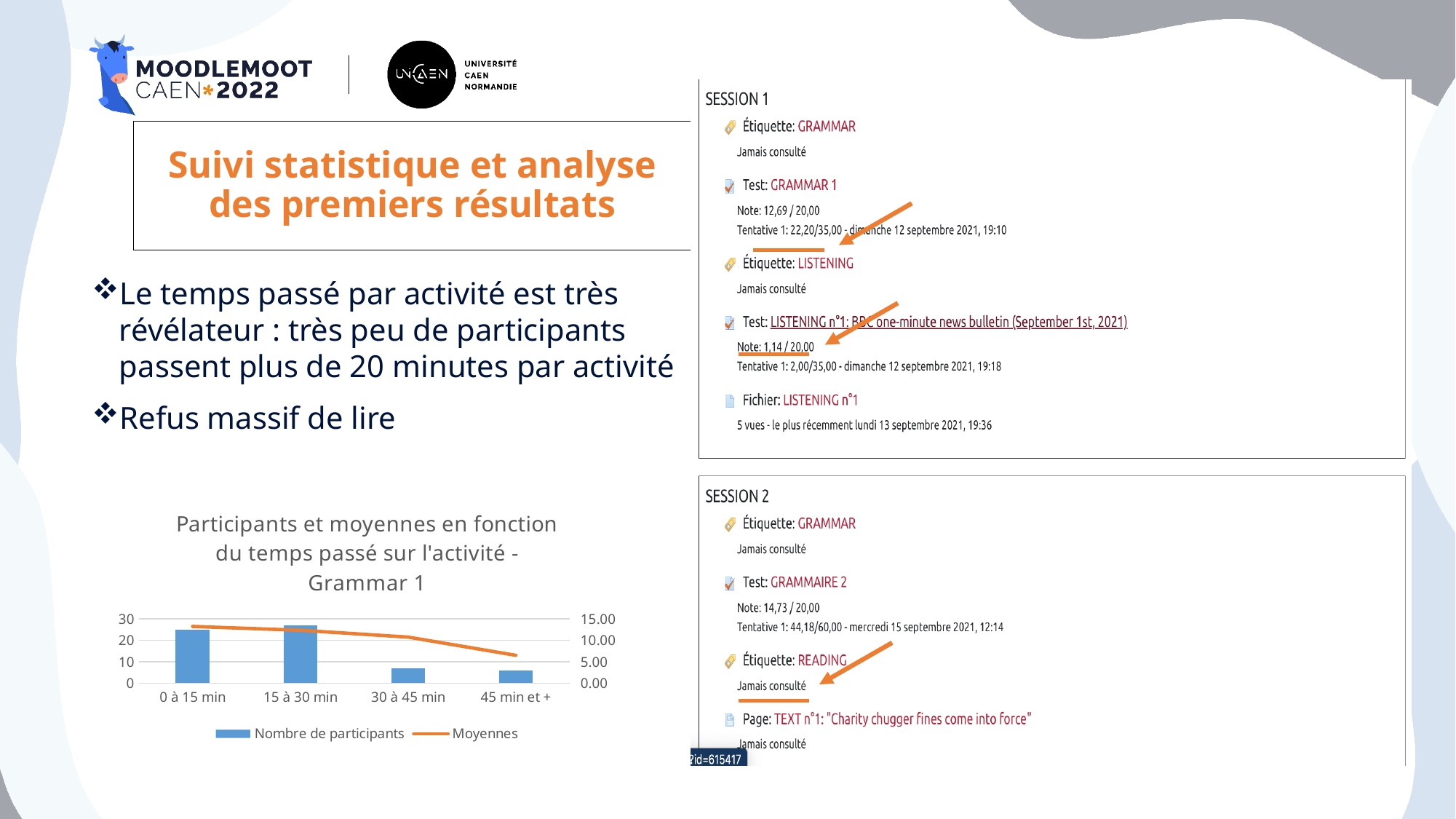
Which series is drawn as a line in the chart? Moyennes Which has more participants: 0 à 15 min or 30 à 45 min? 0 à 15 min Does the Moyennes line rise or fall from 0 à 15 min to 45 min et +? It falls Which time category has the highest number of participants? 15 à 30 min Is the number of participants for 45 min et + greater or less than 10? less How many series does the chart legend list? 2 Is the number of participants for 30 à 45 min greater or less than 10? less How many time categories are shown on the x axis of the chart? 4 What is the title of the chart on the slide? Participants et moyennes en fonction du temps passé sur l'activité - Grammar 1 Is the number of participants for 0 à 15 min greater or less than 20? greater What kind of chart is shown on the slide? A bar chart combined with a line